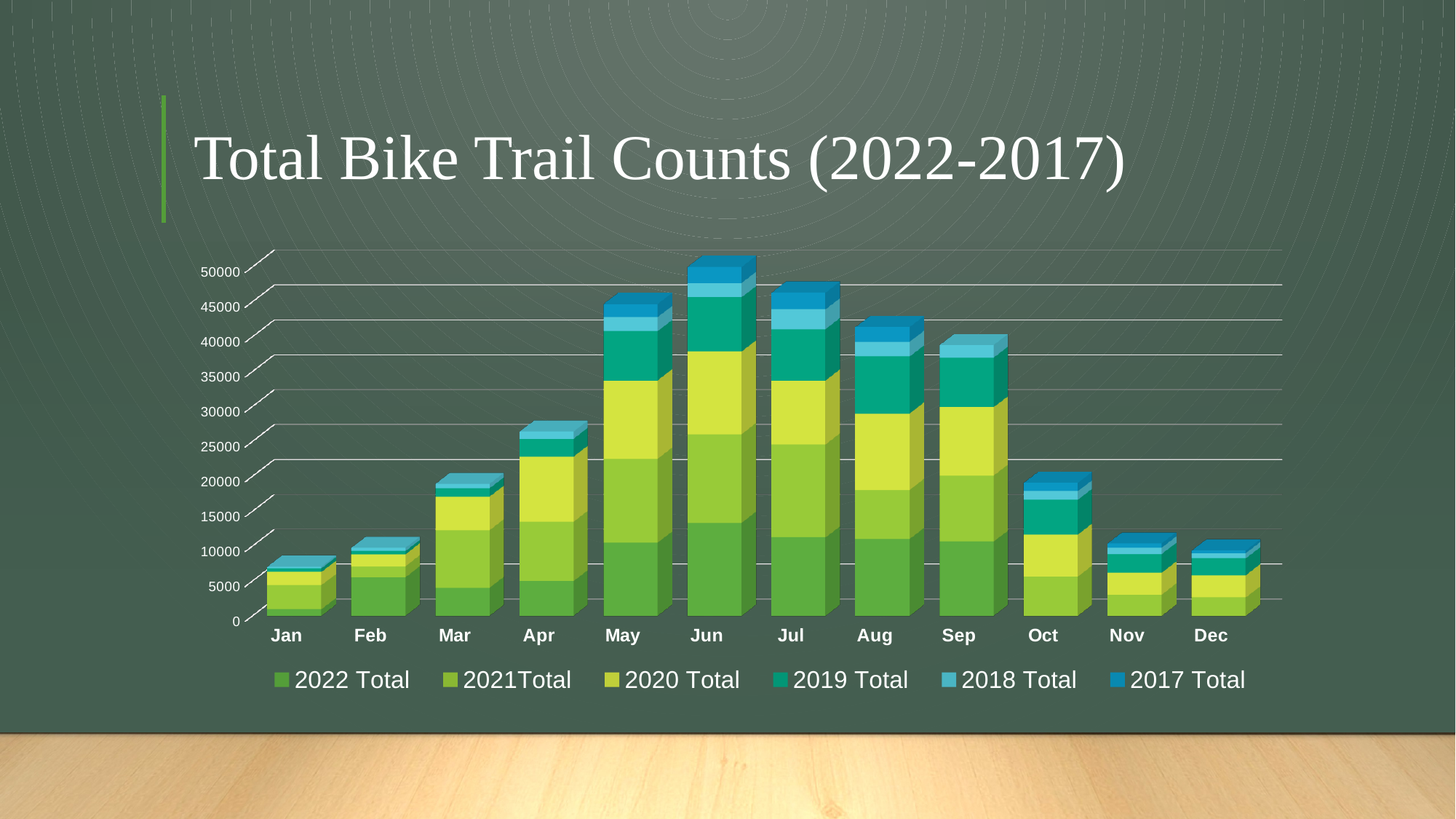
Is the total for Nov greater or less than 15000? less Which month has a larger total, May or Aug? May Is the total for Aug greater or less than 35000? greater How many months are shown along the x axis? 12 Do the total counts rise or fall from Jun to Dec? fall Which month has the lowest total bike trail count? Jan What is the title of the chart slide? Total Bike Trail Counts (2022-2017) How many series does the legend list? 6 What kind of chart is shown on the slide? Stacked bar chart Is the total for Jun greater or less than 40000? greater Which month has the highest total bike trail count? Jun